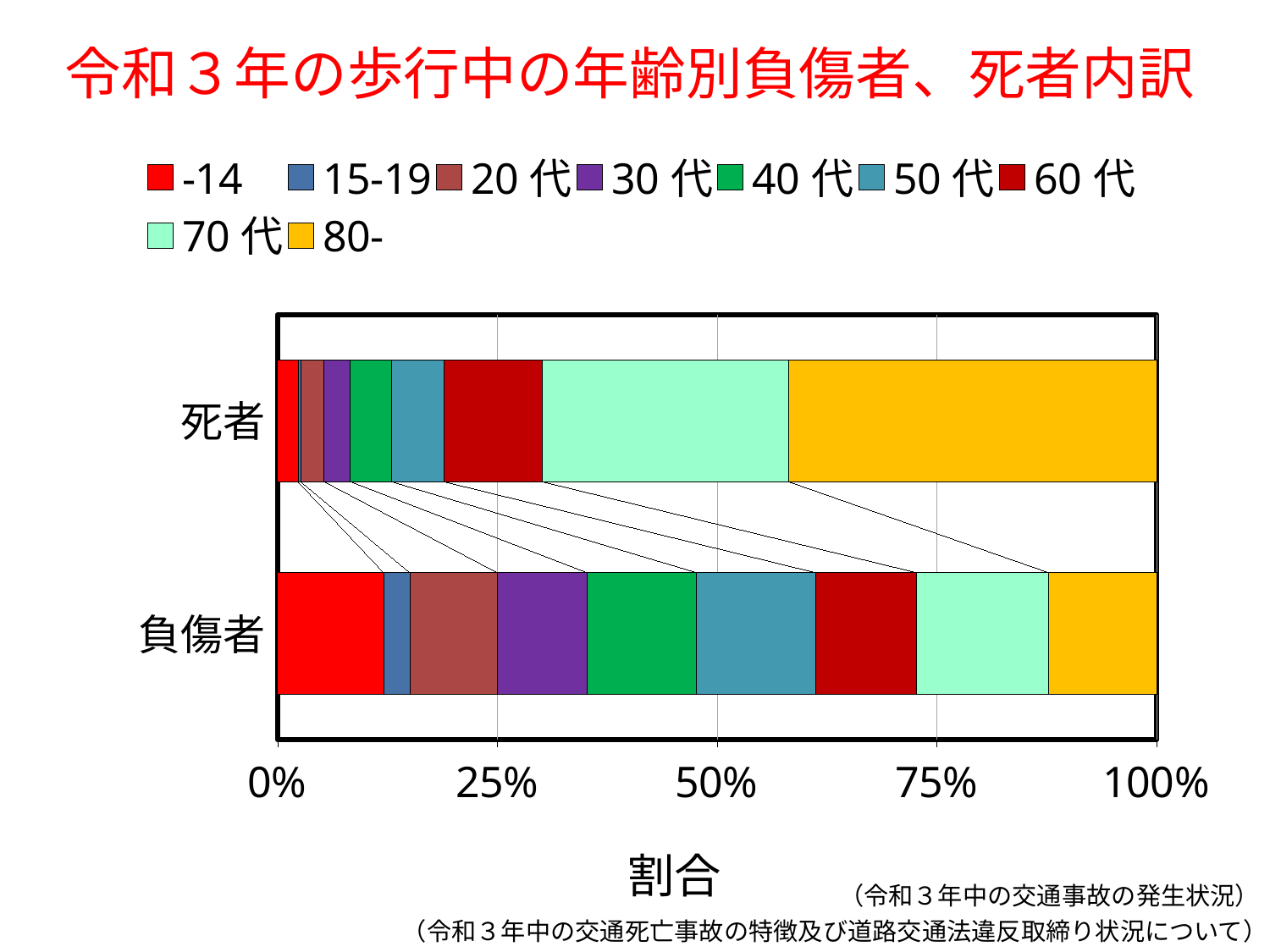
Is the share of the 80- group in the 死者 bar greater or less than 25%? greater Which bar has the larger share for the 80- group, 死者 or 負傷者? 死者 Is the share of the 80- group in the 負傷者 bar greater or less than 25%? less What kind of chart is shown on the slide? Stacked bar chart What is the label of the horizontal axis? 割合 How many categories (bars) does the chart show? 2 Is the share of the -14 group in the 負傷者 bar greater or less than 25%? less Which age group has the largest share in the 死者 bar? 80- How many series does the legend list? 9 Which bar has the larger share for the 70代 group, 死者 or 負傷者? 死者 What is the title of the chart on the slide? 令和３年の歩行中の年齢別負傷者、死者内訳 Which bar has the larger share for the -14 group, 死者 or 負傷者? 負傷者